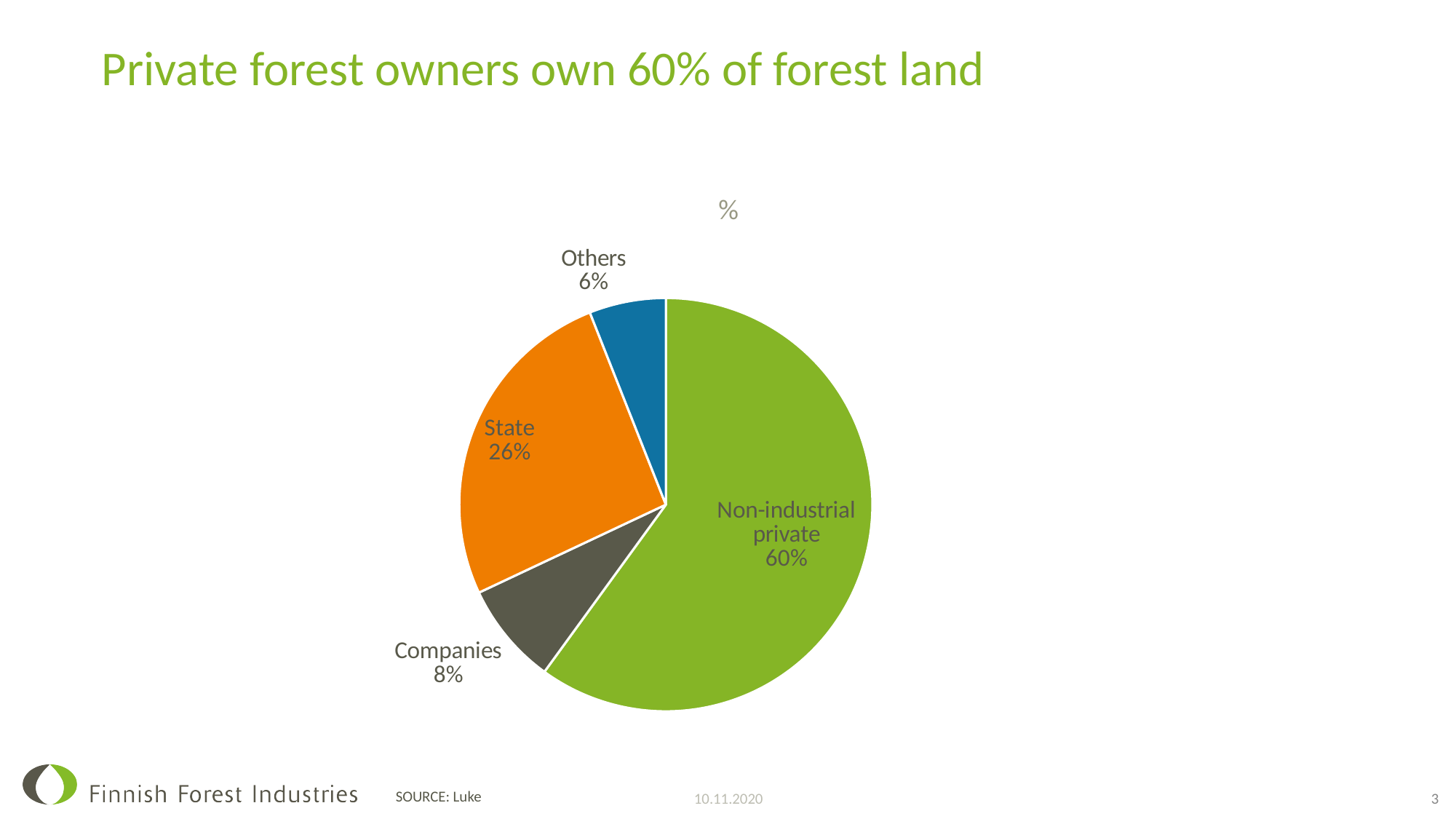
What share of forest land is owned by non-industrial private owners? 60% How many slices does the pie chart have? 4 Which owner category has the largest share of forest land? Non-industrial private What share of forest land is owned by the State? 26% Which owner category has the smallest share of forest land? Others What share of forest land is owned by Companies? 8% Which is larger, the share for Companies or the share for Others? Companies How many percentage points larger is the State share than the Companies share? 18 What is the title of the slide? Private forest owners own 60% of forest land What share of forest land is owned by Others? 6% What kind of chart is shown on the slide? pie chart What is the difference in percentage points between the Non-industrial private share and the State share? 34